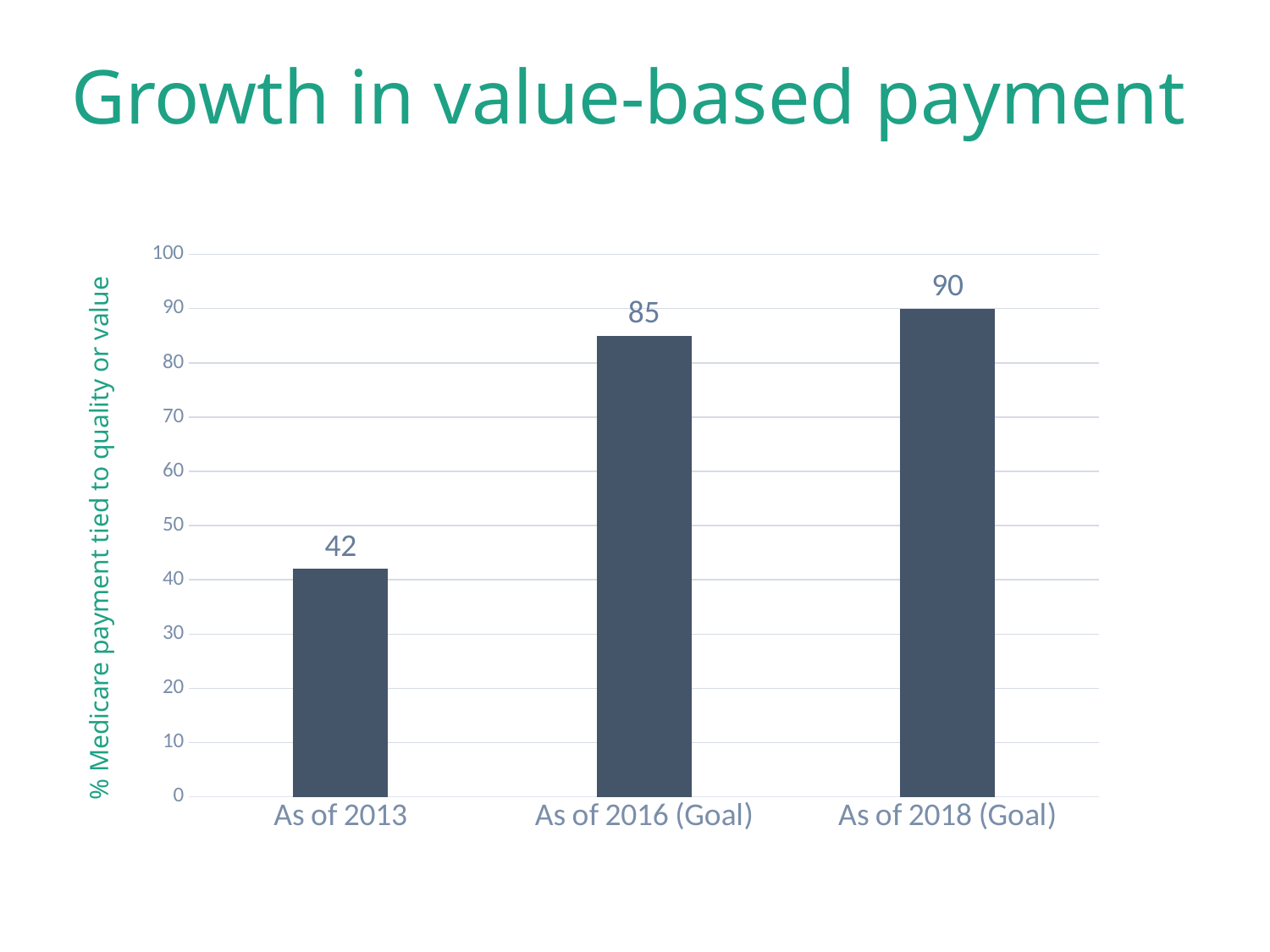
Do the values rise or fall from left to right along the x axis? rise What is the value for As of 2018 (Goal)? 90 What is the difference between the values for As of 2018 (Goal) and As of 2016 (Goal)? 5 What is the value for As of 2016 (Goal)? 85 Which category has the highest value? As of 2018 (Goal) Which is larger, the value for As of 2013 or the value for As of 2016 (Goal)? As of 2016 (Goal) Is the value for As of 2013 greater or less than 50? less What is the value for As of 2013? 42 What is the difference between the values for As of 2016 (Goal) and As of 2013? 43 What kind of chart is shown on the slide? bar chart Which category has the lowest value? As of 2013 How many categories are shown on the x axis? 3